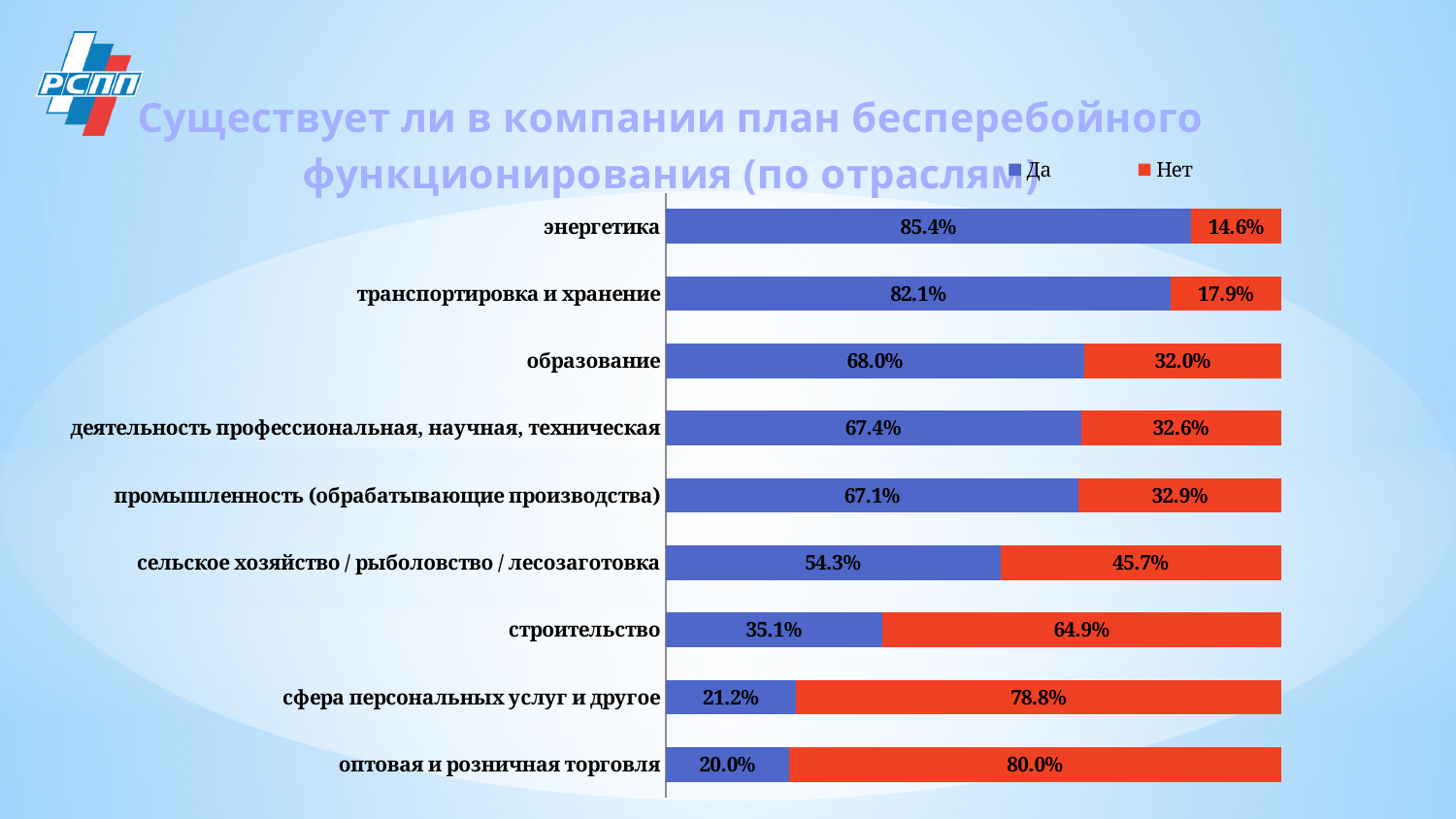
What is the "Да" value for энергетика? 85.4% Which is larger: the "Да" value for транспортировка и хранение or for образование? транспортировка и хранение Which industry has the highest "Да" value? энергетика Which colour represents the "Нет" series? red How many industries are shown in the chart? 9 Which industry has the lowest "Да" value? оптовая и розничная торговля What is the "Нет" value for строительство? 64.9% What is the difference between the "Нет" values for образование and энергетика? 17.4% How many series does the legend list? 2 What kind of chart is shown on the slide? stacked bar chart What is the "Да" value for сельское хозяйство / рыболовство / лесозаготовка? 54.3% What is the total of the stacked bar for сфера персональных услуг и другое? 100.0%